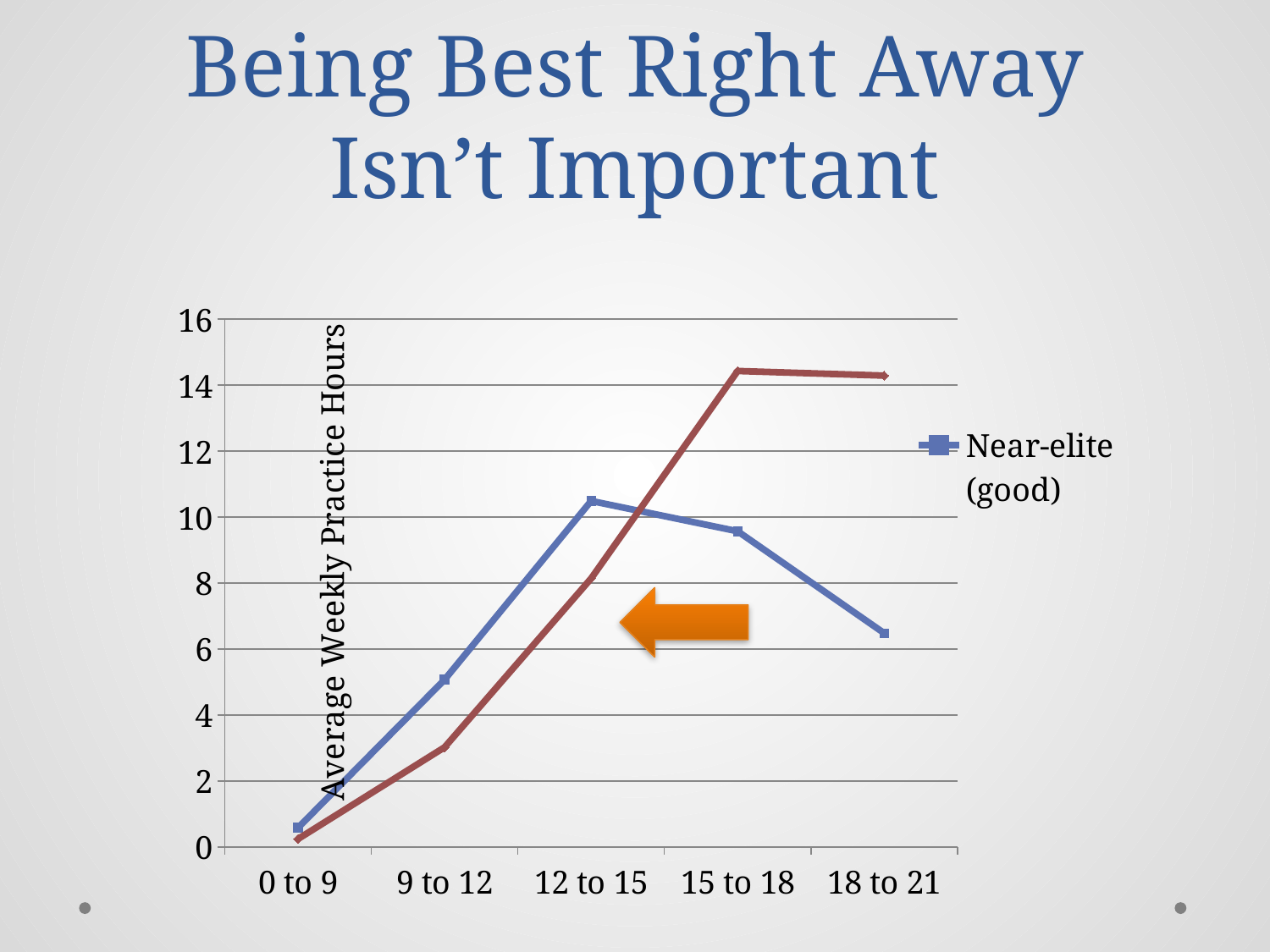
Is the value for Near-elite (good) at 18 to 21 greater or less than 8? less Is the value for Near-elite (good) at 15 to 18 greater or less than 8? greater In which age category is the Near-elite (good) series at its lowest value? 0 to 9 Is the value for Near-elite (good) at 9 to 12 greater or less than 4? greater In which age category does the Near-elite (good) series reach its highest value? 12 to 15 What is the title of the vertical axis? Average Weekly Practice Hours How many categories are shown on the x axis? 5 How many series does the legend list? 1 What series name is shown in the legend? Near-elite (good) What kind of chart is shown on the slide? line chart Does the Near-elite (good) series rise or fall between 12 to 15 and 18 to 21? fall